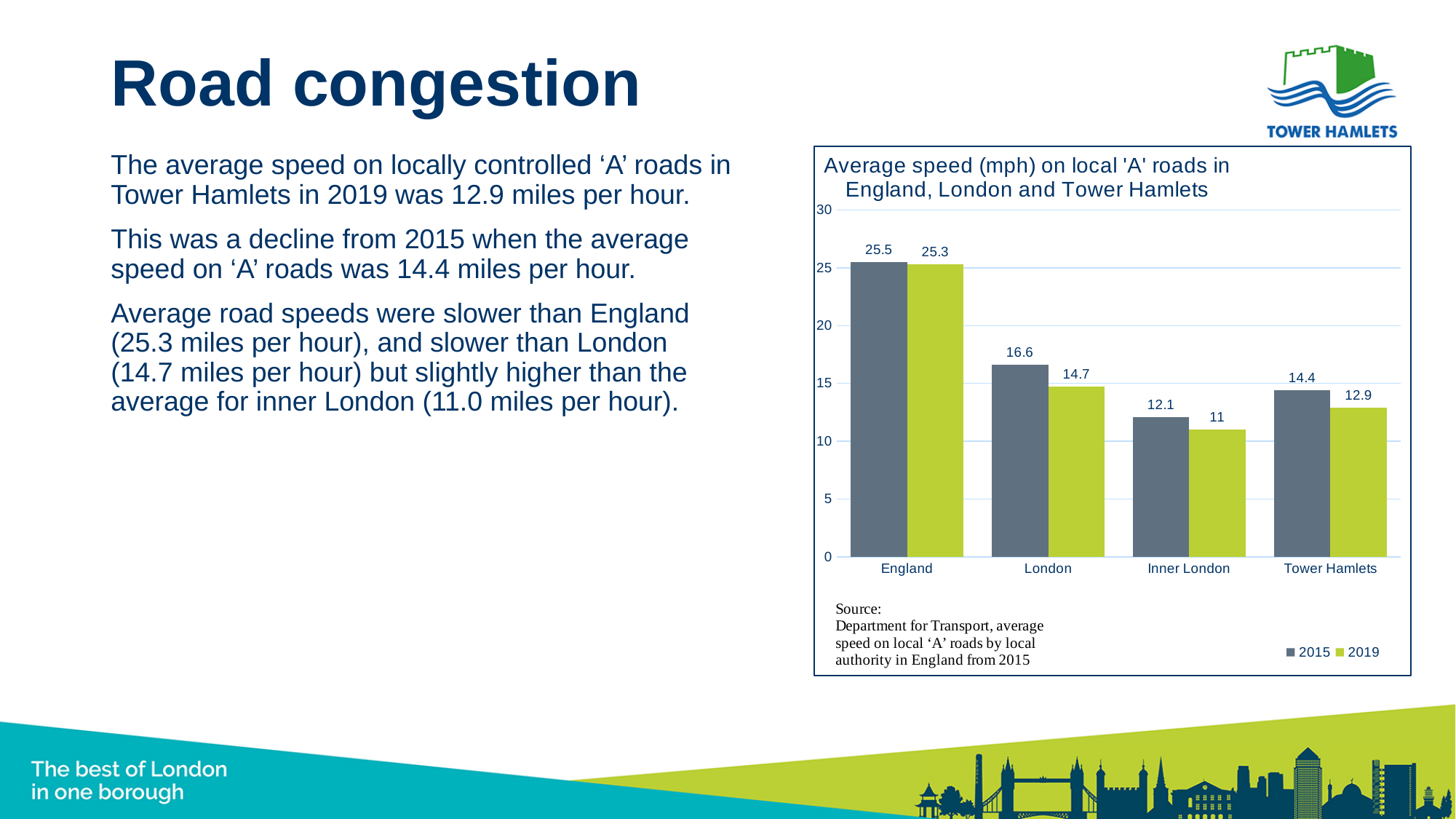
How many areas are shown on the x axis of the chart? 4 What type of chart is used to show average speeds on local 'A' roads? Bar chart What was the average speed on local 'A' roads in London in 2015? 16.6 Which area had the highest average speed in 2019? England What was the average speed on local 'A' roads in Tower Hamlets in 2019? 12.9 By how much did the average speed in Tower Hamlets fall between 2015 and 2019? 1.5 What was the average speed on local 'A' roads in Inner London in 2019? 11 Which colour represents the 2019 series in the chart? Green Which area had the lowest average speed in 2015? Inner London Which was higher in 2019: the average speed in Tower Hamlets or in Inner London? Tower Hamlets What is the difference between the 2019 average speeds for London and Tower Hamlets? 1.8 How many series does the chart's legend list? 2